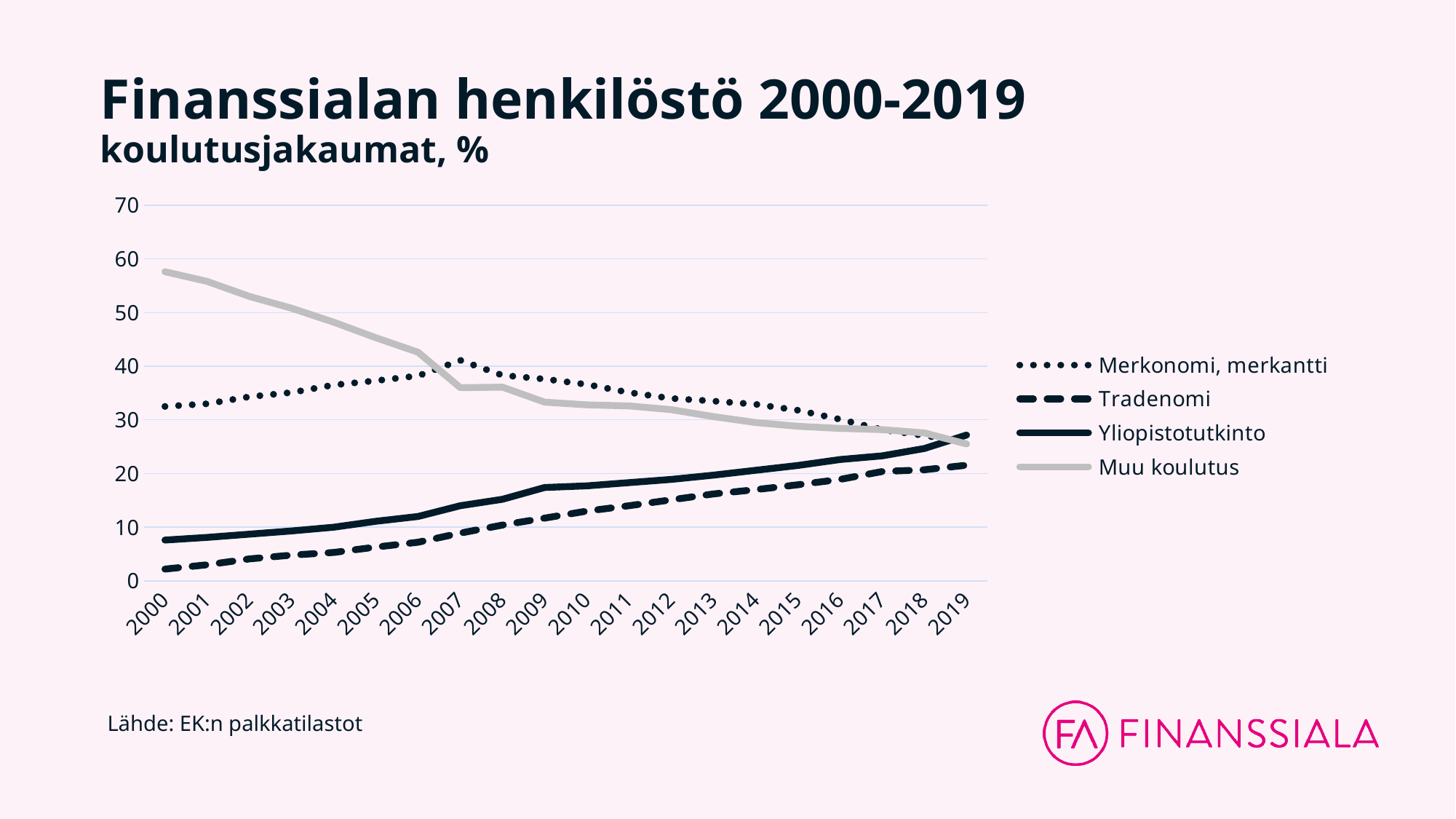
Is the value for Yliopistotutkinto in 2019 greater or less than 20? greater Which series has the lowest value in 2019? Tradenomi Which series has the lowest value in 2000? Tradenomi How many series does the legend list? 4 Does the Muu koulutus series rise or fall from 2000 to 2019? Fall In 2019, which is larger: Yliopistotutkinto or Tradenomi? Yliopistotutkinto Which series has the highest value in 2000? Muu koulutus Is the value for Tradenomi in 2000 greater or less than 10? less Is the value for Muu koulutus in 2000 greater or less than 50? greater What kind of chart is shown on the slide? Line chart How many years are shown on the x axis? 20 Does the Tradenomi series rise or fall from 2000 to 2019? Rise